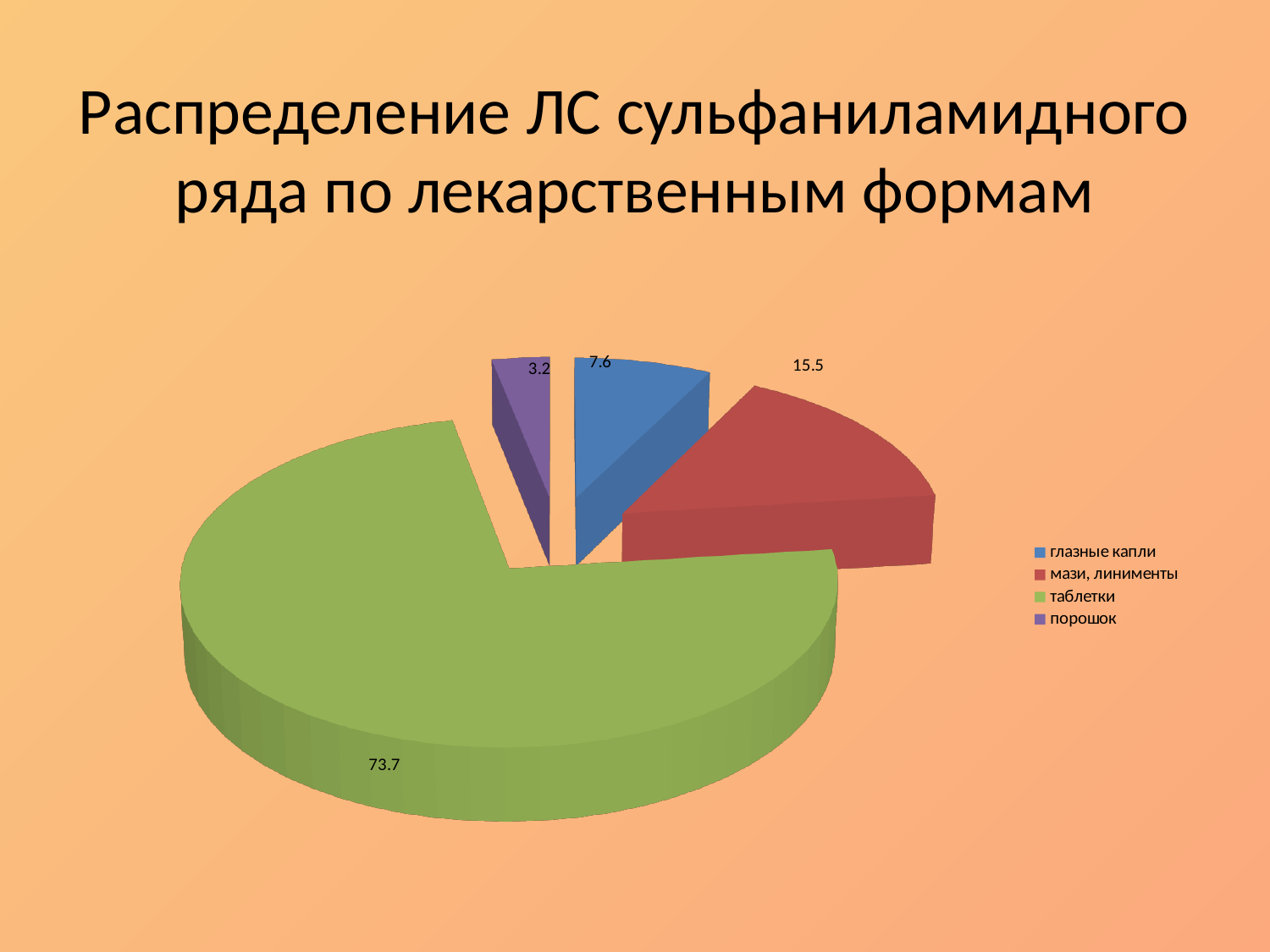
Which category has the largest slice of the pie? таблетки What value is shown for глазные капли? 7.6 Which category has the smallest slice of the pie? порошок What value is shown for порошок? 3.2 What is the title of the chart on the slide? Распределение ЛС сульфаниламидного ряда по лекарственным формам Which is larger, the value for глазные капли or the value for порошок? глазные капли What is the difference between the values for мази, линименты and глазные капли? 7.9 What value is shown for мази, линименты? 15.5 What is the difference between the values for таблетки and мази, линименты? 58.2 What kind of chart is shown on the slide? pie chart What value is shown for таблетки? 73.7 How many categories does the pie chart show? 4